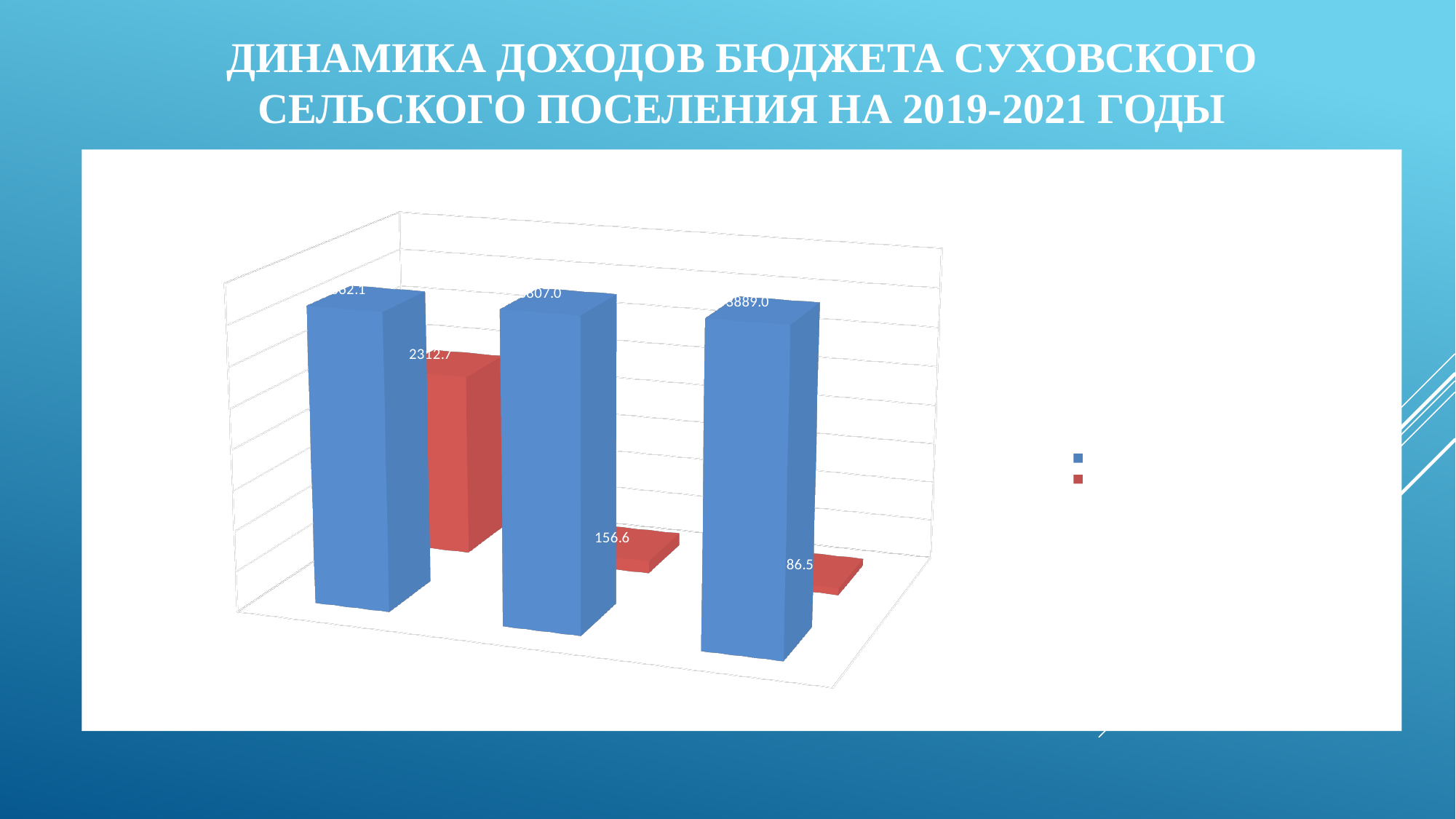
What kind of chart is shown on the slide? bar chart How many series does the chart's legend list? 2 How many groups of bars does the chart show? 3 What is the value of the red bar in the third (rightmost) group? 86.5 What is the value of the blue bar in the third (rightmost) group? 3889.0 What is the value of the red bar in the first (leftmost) group? 2312.7 Which group has the lowest red bar? the third (rightmost) group What is the difference between the red bar in the first group (2312.7) and the red bar in the second group (156.6)? 2156.1 What is the value of the red bar in the second (middle) group? 156.6 What is the title of the slide? ДИНАМИКА ДОХОДОВ БЮДЖЕТА СУХОВСКОГО СЕЛЬСКОГО ПОСЕЛЕНИЯ НА 2019-2021 ГОДЫ Which group has the highest red bar? the first (leftmost) group Do the red bars rise or fall from left to right across the groups? fall